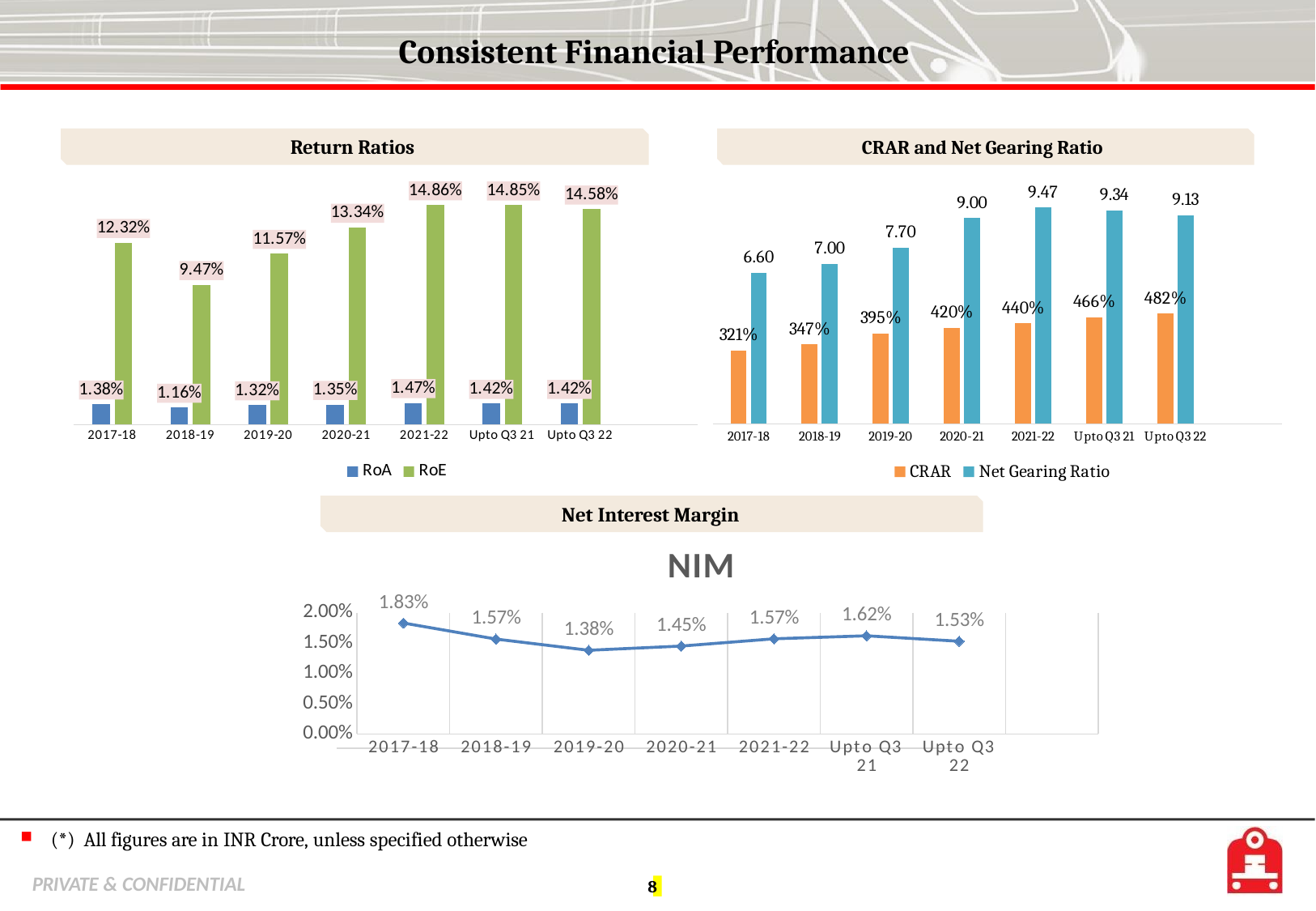
In the CRAR and Net Gearing Ratio chart, is the Net Gearing Ratio higher in 2020-21 or in Upto Q3 22? Upto Q3 22 In the NIM chart, what is the value for 2019-20? 1.38% In the CRAR and Net Gearing Ratio chart, does CRAR rise or fall from 2017-18 to Upto Q3 22? Rise In the Return Ratios chart, which period has the highest RoE? 2021-22 How many series does the legend of the Return Ratios chart list? 2 In the Return Ratios chart, which period has the lowest RoA? 2018-19 In the Return Ratios chart, what is the difference between the RoE for 2017-18 and 2018-19? 2.85% What kind of chart is the Net Interest Margin (NIM) chart? Line chart How many periods are plotted in the NIM chart? 7 In the CRAR and Net Gearing Ratio chart, which period has the highest Net Gearing Ratio? 2021-22 In the Return Ratios chart, what is the RoE value for 2020-21? 13.34% In the CRAR and Net Gearing Ratio chart, what is the CRAR value for 2019-20? 395%